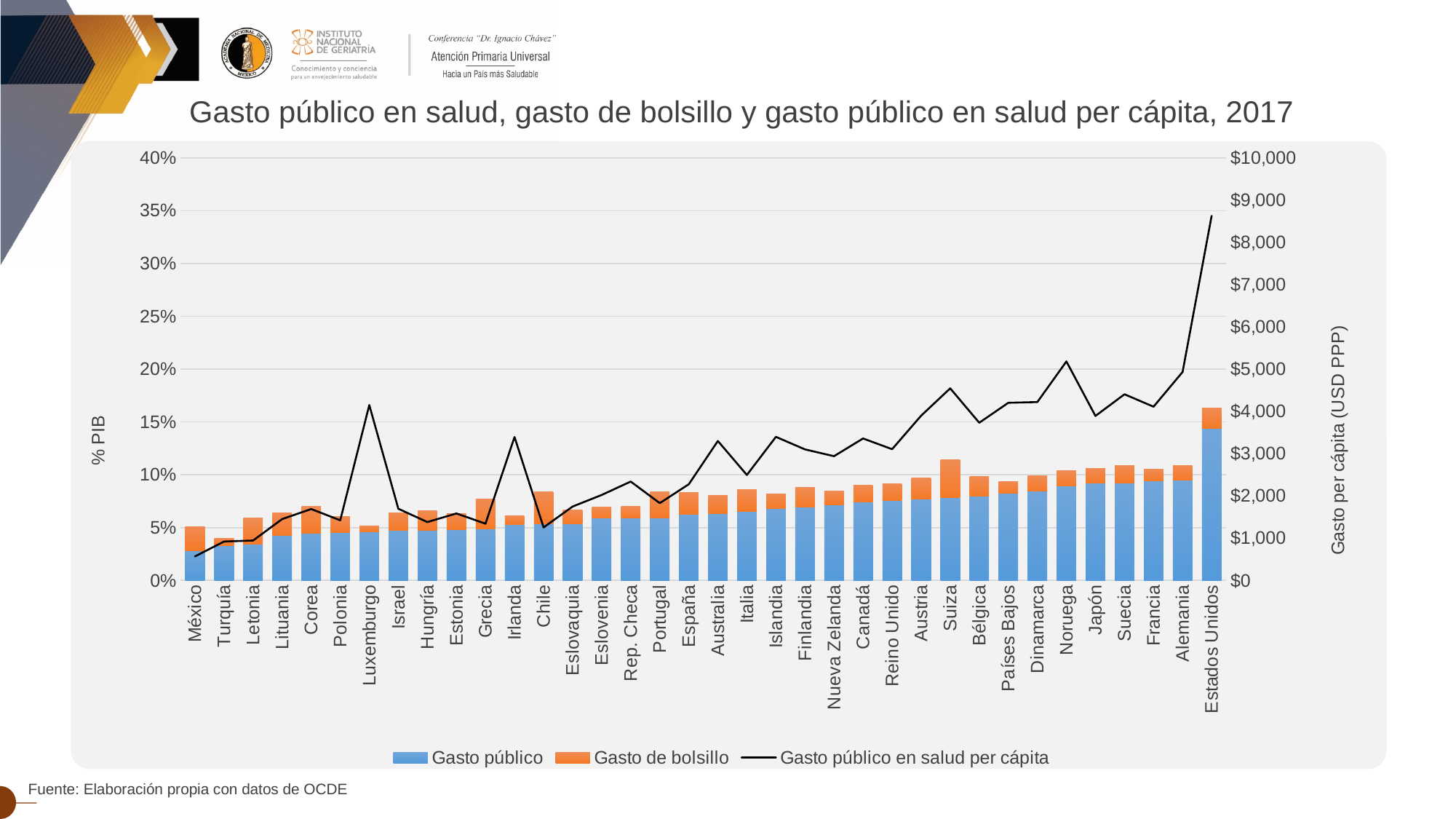
Which country has the highest Gasto público as a share of GDP? Estados Unidos Which has a higher Gasto público en salud per cápita, Luxemburgo or Irlanda? Luxemburgo What kind of chart is shown on the slide? A combination of a stacked bar chart and a line chart Is the Gasto público value for Estados Unidos greater or less than 10%? greater How many countries are shown on the x axis? 36 Which country has the highest Gasto público en salud per cápita? Estados Unidos Is the Gasto público en salud per cápita for Estados Unidos greater or less than $8,000? greater How many series does the legend list? 3 Is the Gasto público en salud per cápita for Luxemburgo greater or less than $3,000? greater Which country has the lowest Gasto público as a share of GDP? México Which country has the lowest Gasto público en salud per cápita? México What is the label of the right-hand vertical axis? Gasto per cápita (USD PPP)